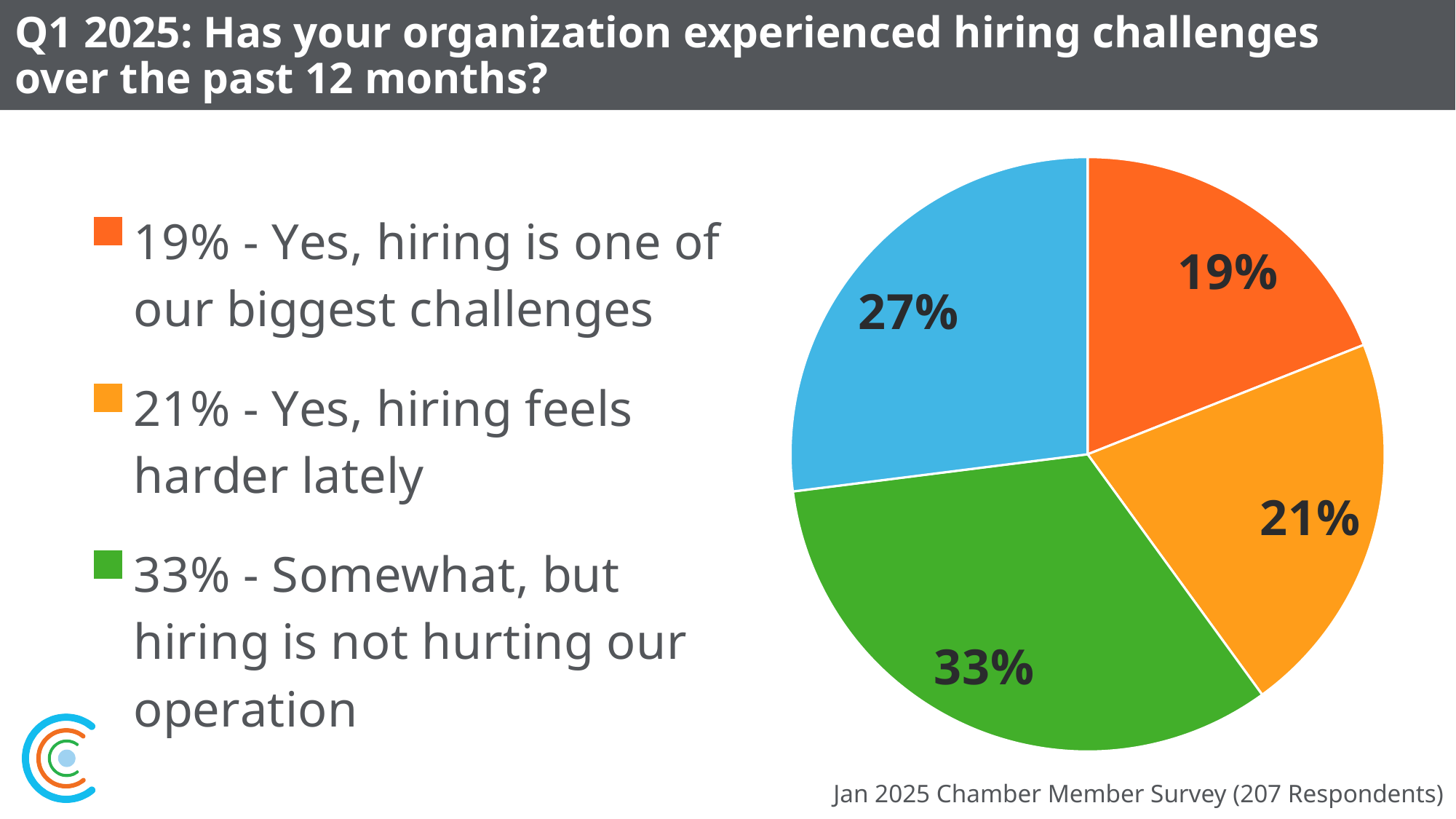
What kind of chart is shown on the slide? pie chart Which response has the smallest share of the pie? Yes, hiring is one of our biggest challenges Which is larger: the share for 'Yes, hiring feels harder lately' or the share shown on the blue slice? the blue slice (27%) What is the difference in percentage points between 'Somewhat, but hiring is not hurting our operation' and 'Yes, hiring feels harder lately'? 12 What share of respondents said 'Somewhat, but hiring is not hurting our operation'? 33% How many respondents does the source note say took part in the survey? 207 How many slices does the pie chart have? 4 What share of respondents said 'Yes, hiring feels harder lately'? 21% What colour is the slice representing 'Somewhat, but hiring is not hurting our operation'? green What percentage is shown on the blue slice of the pie chart? 27% What share of respondents said 'Yes, hiring is one of our biggest challenges'? 19% Which response has the largest share of the pie? Somewhat, but hiring is not hurting our operation